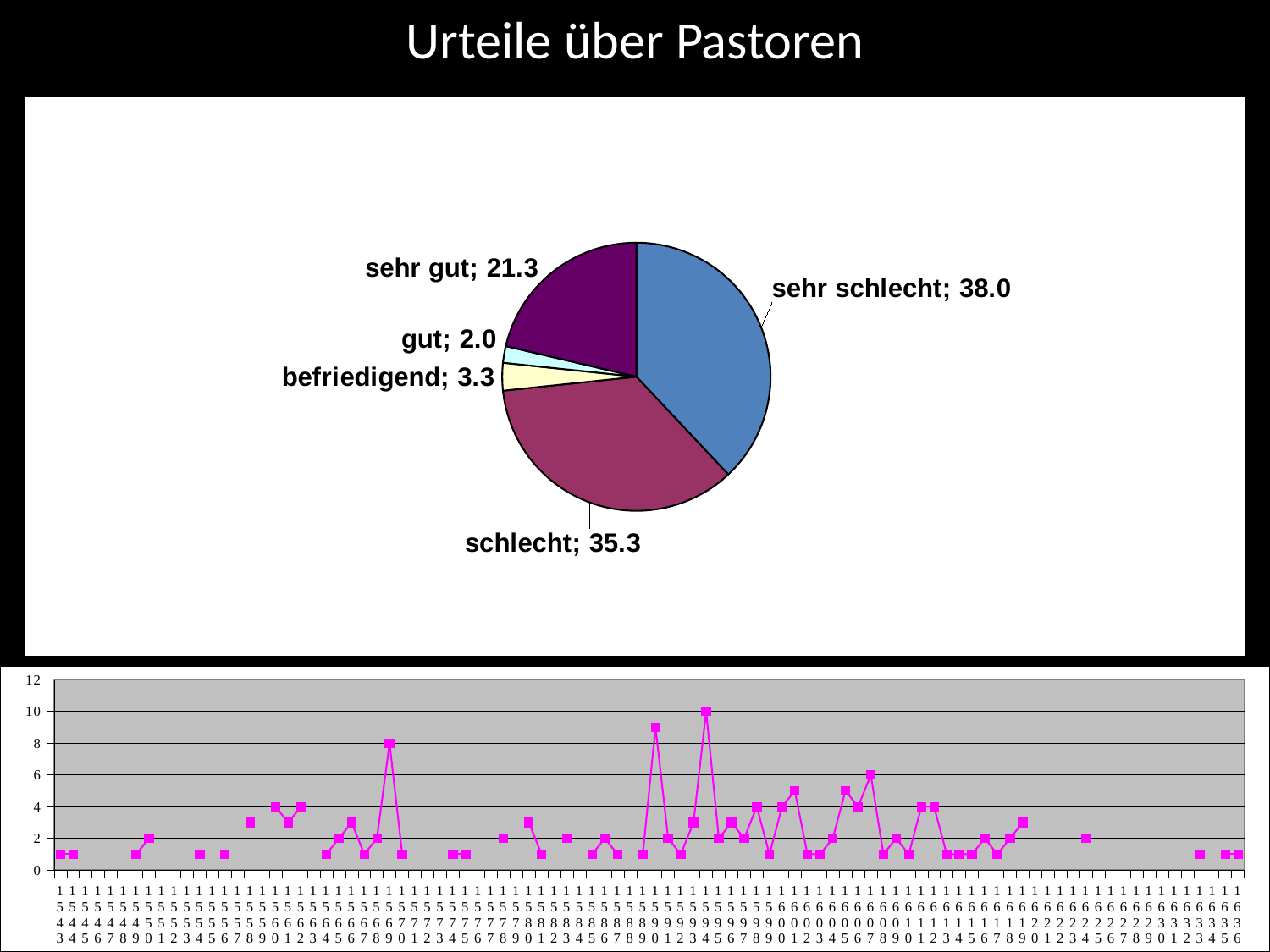
In the pie chart, what value is shown for 'befriedigend'? 3.3 In the lower line chart, is the highest point greater or less than 8? greater What kind of chart is the lower chart on the slide? line chart In the pie chart, what is the difference between the values for 'sehr schlecht' and 'schlecht'? 2.7 In the pie chart, which is larger: the value for 'sehr gut' or the value for 'befriedigend'? sehr gut In the pie chart, which category has the largest slice? sehr schlecht In the pie chart, what value is shown for 'schlecht'? 35.3 What kind of chart is the upper chart on the slide? pie chart In the pie chart, which category has the smallest slice? gut In the pie chart, what value is shown for 'sehr gut'? 21.3 How many slices does the pie chart have? 5 In the pie chart, what value is shown for 'sehr schlecht'? 38.0